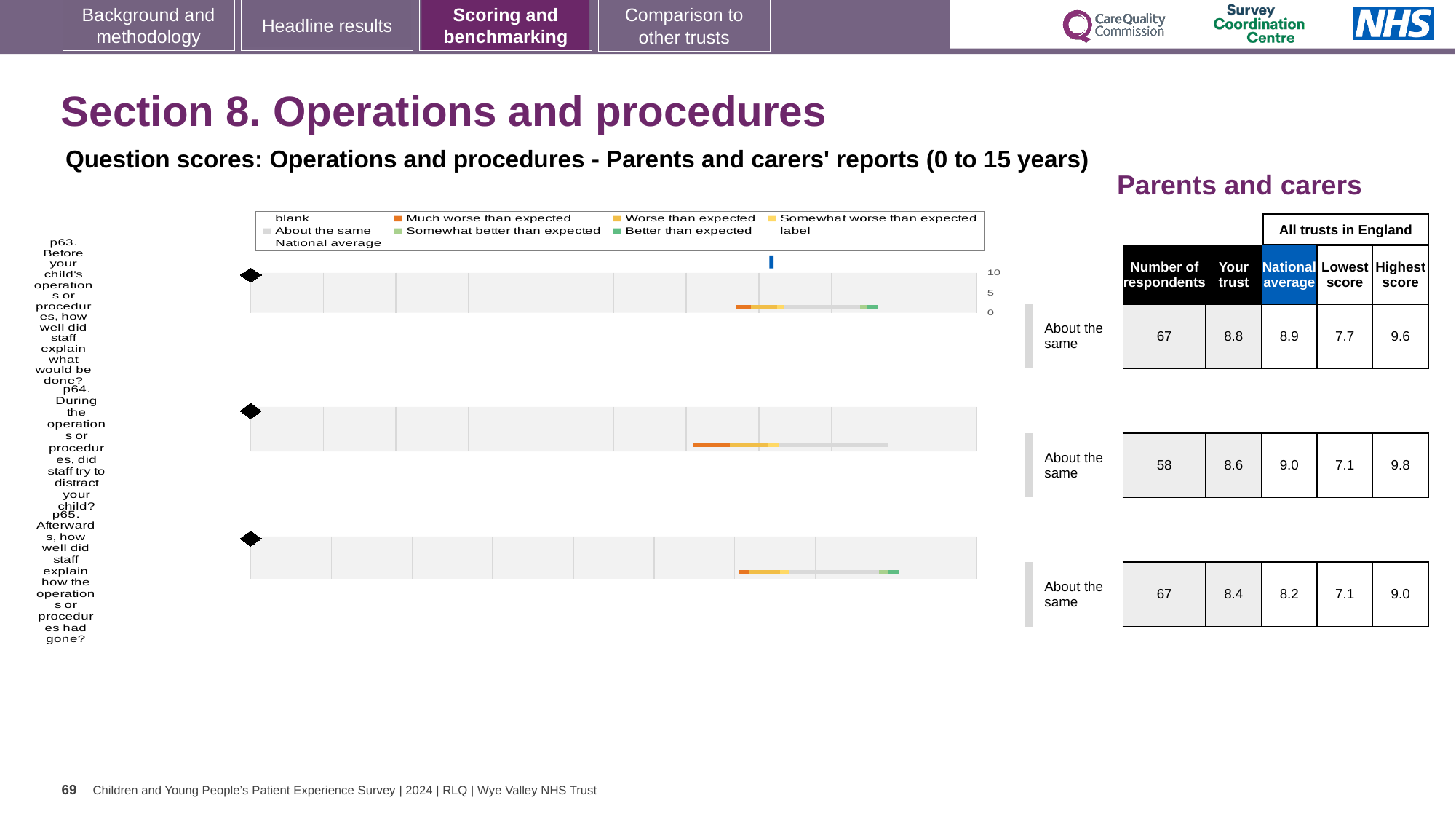
How many questions (p63, p64, p65) are plotted on the slide? 3 How many respondents answered p64? 58 What benchmark category is shown for p64? About the same Which question has the lowest 'Your trust' score? p65 For p63, what is the difference between the highest score (9.6) and the lowest score (7.7) across all trusts? 1.9 What kind of chart is used to show the question scores on this slide? bar chart What is the national average score for p64 (did staff try to distract your child during the operation)? 9.0 For p65, which is larger: the 'Your trust' score or the national average? Your trust What colour does the legend use for 'Much worse than expected'? orange Which question has the highest 'Your trust' score? p63 What is the highest score across all trusts in England for p65? 9.0 What is the 'Your trust' score for p63 (how well staff explained what would be done before the operation)? 8.8